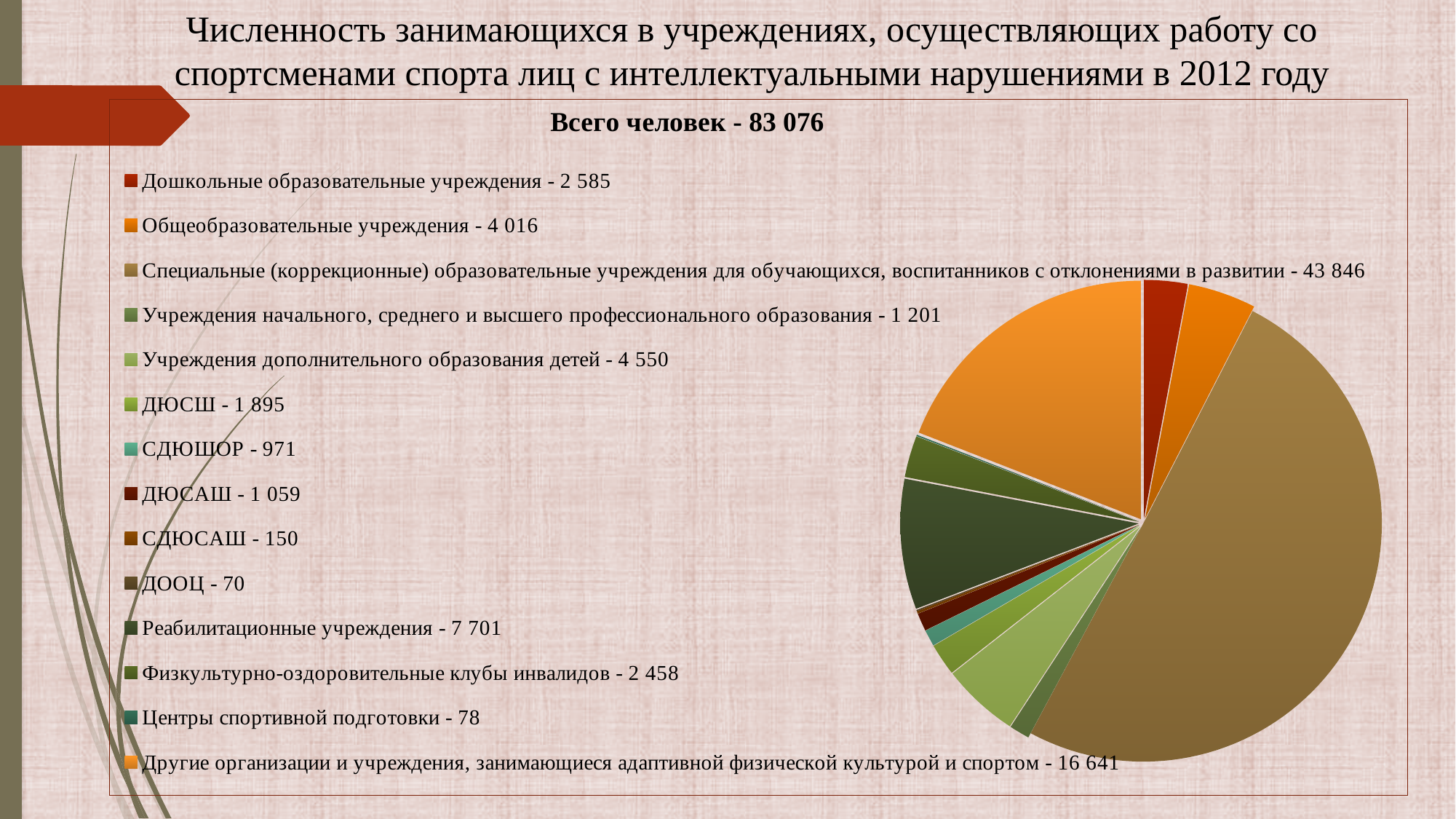
What is the total number of people given on the slide (Всего человек)? 83 076 What kind of chart is shown on the slide? Pie chart What is the difference between the values for Специальные (коррекционные) образовательные учреждения and Другие организации и учреждения, занимающиеся адаптивной физической культурой и спортом? 27 205 What is the value for Специальные (коррекционные) образовательные учреждения для обучающихся, воспитанников с отклонениями в развитии? 43 846 How many categories does the pie chart legend list? 14 Which is larger: the value for Учреждения дополнительного образования детей or for Общеобразовательные учреждения? Учреждения дополнительного образования детей Which category has the largest slice of the pie? Специальные (коррекционные) образовательные учреждения для обучающихся, воспитанников с отклонениями в развитии What is the value for ДЮСШ? 1 895 What is the difference between the values for Реабилитационные учреждения and Физкультурно-оздоровительные клубы инвалидов? 5 243 What is the value for Центры спортивной подготовки? 78 What is the value for Реабилитационные учреждения? 7 701 Which category has the smallest value? ДООЦ